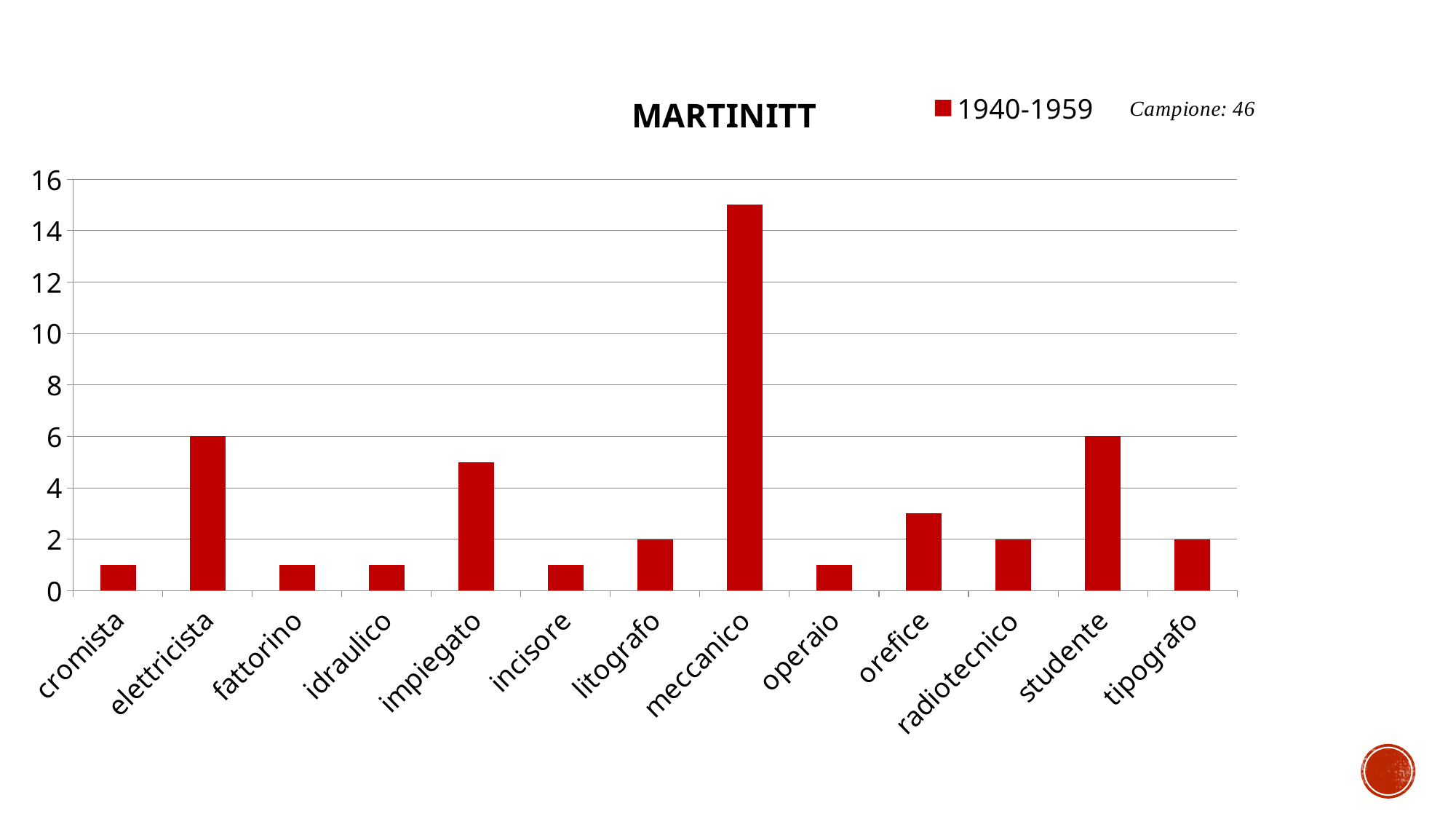
Is the value for impiegato greater or less than 4? greater What kind of chart is shown on the slide? bar chart What is the value for radiotecnico? 2 What is the value for litografo? 2 What is the difference between the values for elettricista and tipografo? 4 What is the value for studente? 6 Is the value for orefice greater or less than 4? less Is the value for meccanico greater or less than 14? greater Which category has the highest value? meccanico Which is larger, the value for elettricista or the value for impiegato? elettricista What is the value for elettricista? 6 How many categories are shown on the x axis? 13